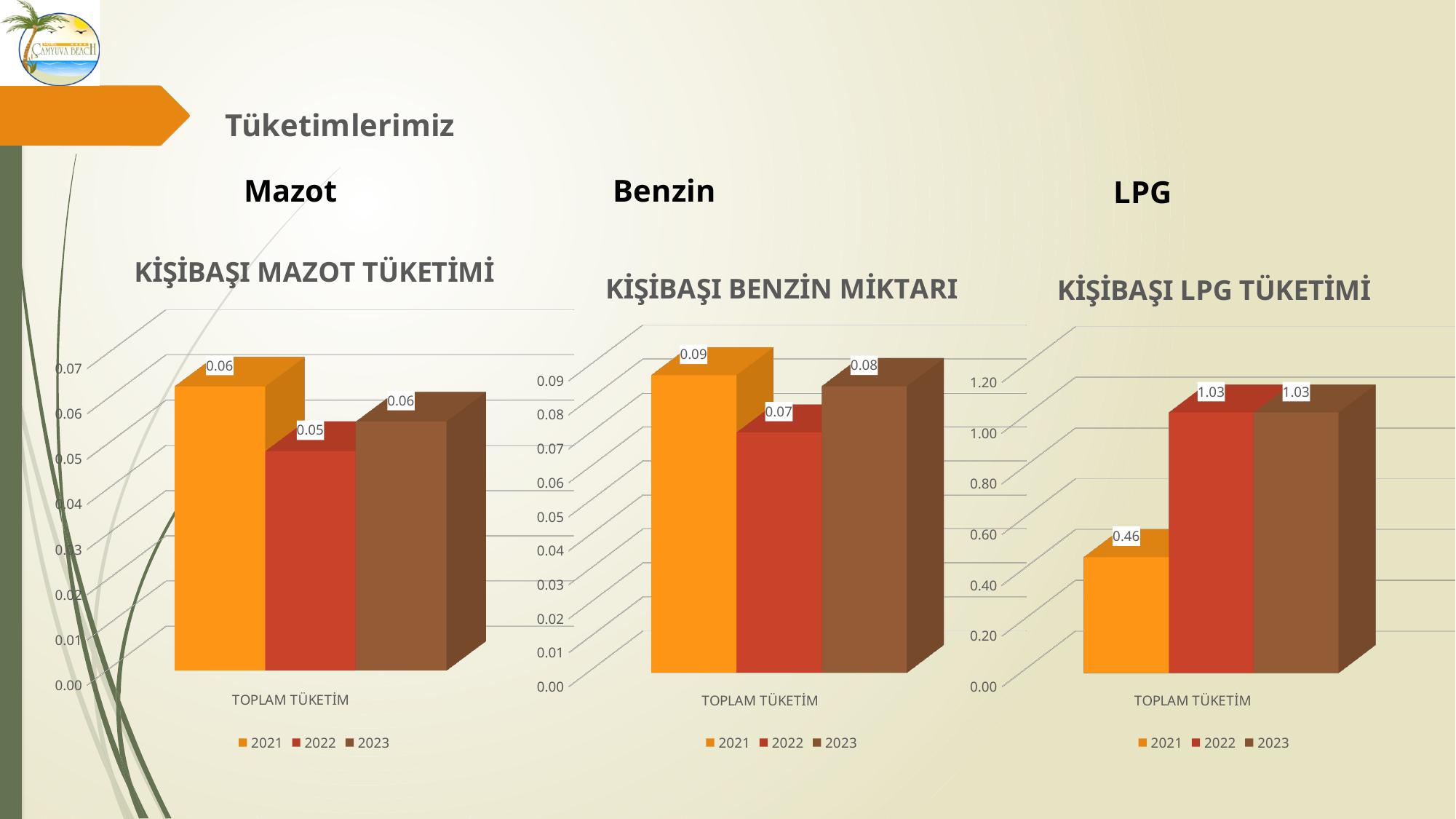
In the KİŞİBAŞI BENZİN MİKTARI chart, which year has the highest value? 2021 In the KİŞİBAŞI LPG TÜKETİMİ chart, what is the difference between the 2022 and 2021 values? 0.57 In the KİŞİBAŞI LPG TÜKETİMİ chart, is the value for 2022 greater or less than 1.00? greater In the KİŞİBAŞI LPG TÜKETİMİ chart, which year has the lowest value? 2021 In the KİŞİBAŞI BENZİN MİKTARI chart, which is larger, the value for 2022 or the value for 2023? 2023 In the KİŞİBAŞI MAZOT TÜKETİMİ chart, which year has the lowest value? 2022 In the KİŞİBAŞI LPG TÜKETİMİ chart, what is the value for 2021? 0.46 What kind of chart is the KİŞİBAŞI LPG TÜKETİMİ chart? bar chart In the KİŞİBAŞI BENZİN MİKTARI chart, what is the difference between the 2021 and 2022 values? 0.02 In the KİŞİBAŞI MAZOT TÜKETİMİ chart, how many series does the legend list? 3 In the KİŞİBAŞI BENZİN MİKTARI chart, what is the value for 2021? 0.09 In the KİŞİBAŞI MAZOT TÜKETİMİ chart, what is the value for 2022? 0.05